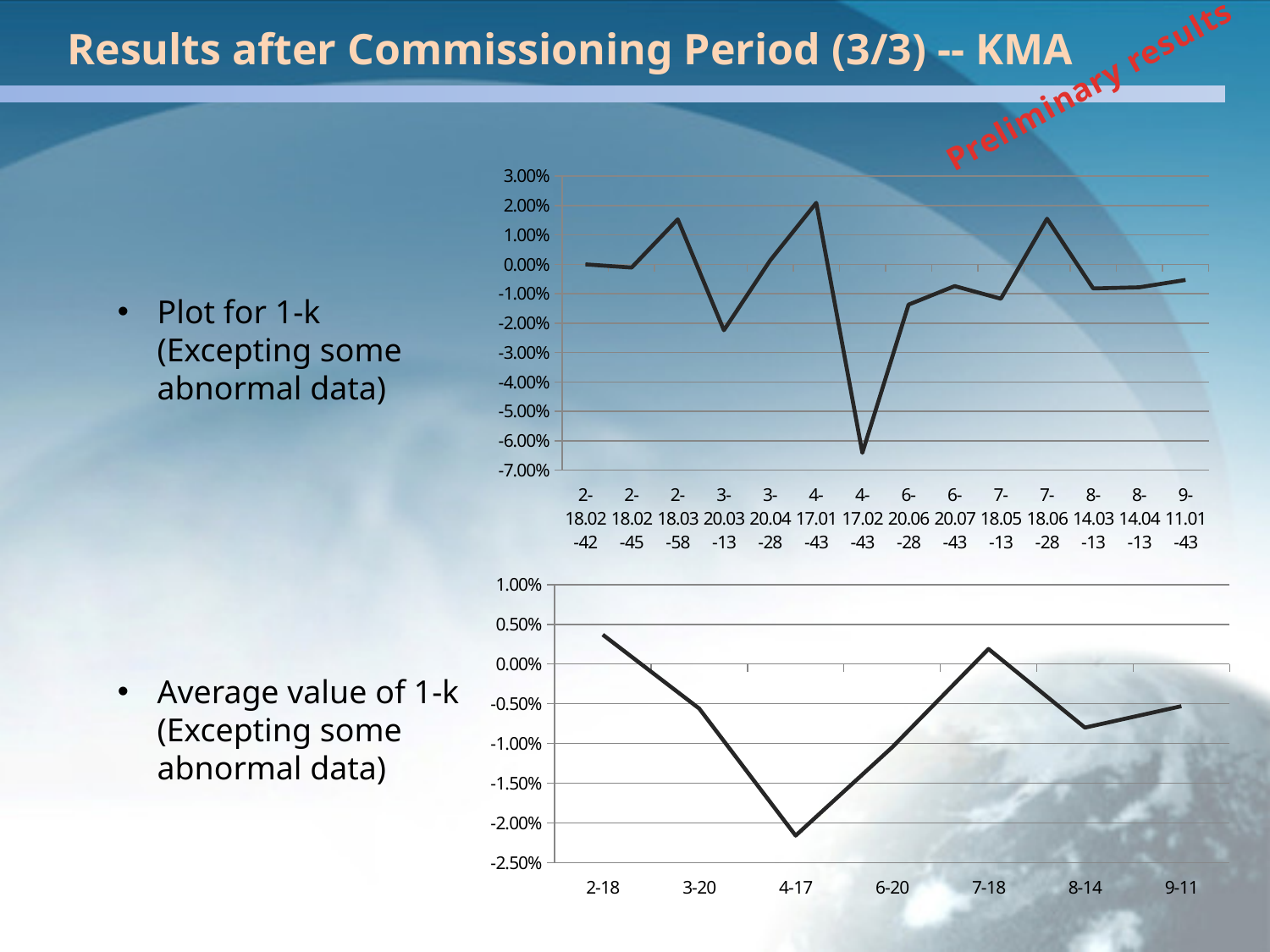
What kind of chart is the top chart on the slide? Line chart In the top chart, which x-axis category has the lowest value? 4-17.02-43 In the top chart, which x-axis category has the highest value? 4-17.01-43 In the top chart, is the value for 4-17.02-43 greater or less than -6.00%? less How many categories are shown on the x axis of the bottom chart? 7 How many data points are plotted in the top chart? 14 In the bottom chart, do the values rise or fall from 2-18 to 4-17? fall In the bottom chart, which category has the lowest value? 4-17 What kind of chart is the bottom chart on the slide? Line chart In the bottom chart, is the value for 8-14 greater or less than -0.50%? less In the top chart, is the value for 2-18.03-58 greater or less than 1.00%? greater In the bottom chart, which category has the highest value? 2-18